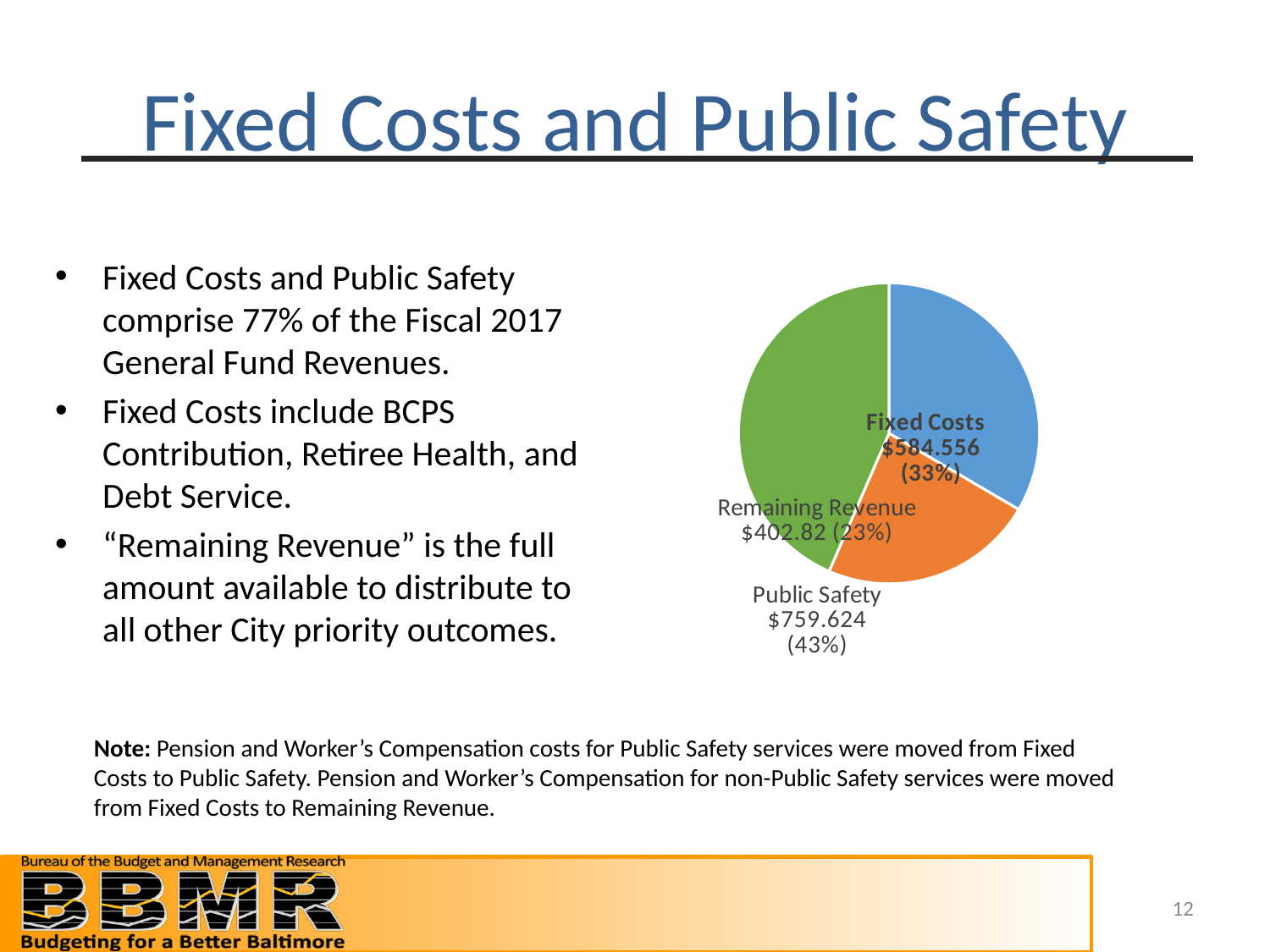
What is the value shown for Fixed Costs in the pie chart? $584.556 Which is larger in the pie chart, Fixed Costs or Remaining Revenue? Fixed Costs What share of the pie does Remaining Revenue represent? 23% What share of the pie does Public Safety represent? 43% What share of the pie does Fixed Costs represent? 33% What colour is the Public Safety slice in the pie chart? orange What kind of chart is shown on the slide? pie chart What is the value shown for Remaining Revenue in the pie chart? $402.82 Which slice of the pie chart is the largest? Public Safety Which slice of the pie chart is the smallest? Remaining Revenue What is the value shown for Public Safety in the pie chart? $759.624 How many slices does the pie chart have? 3